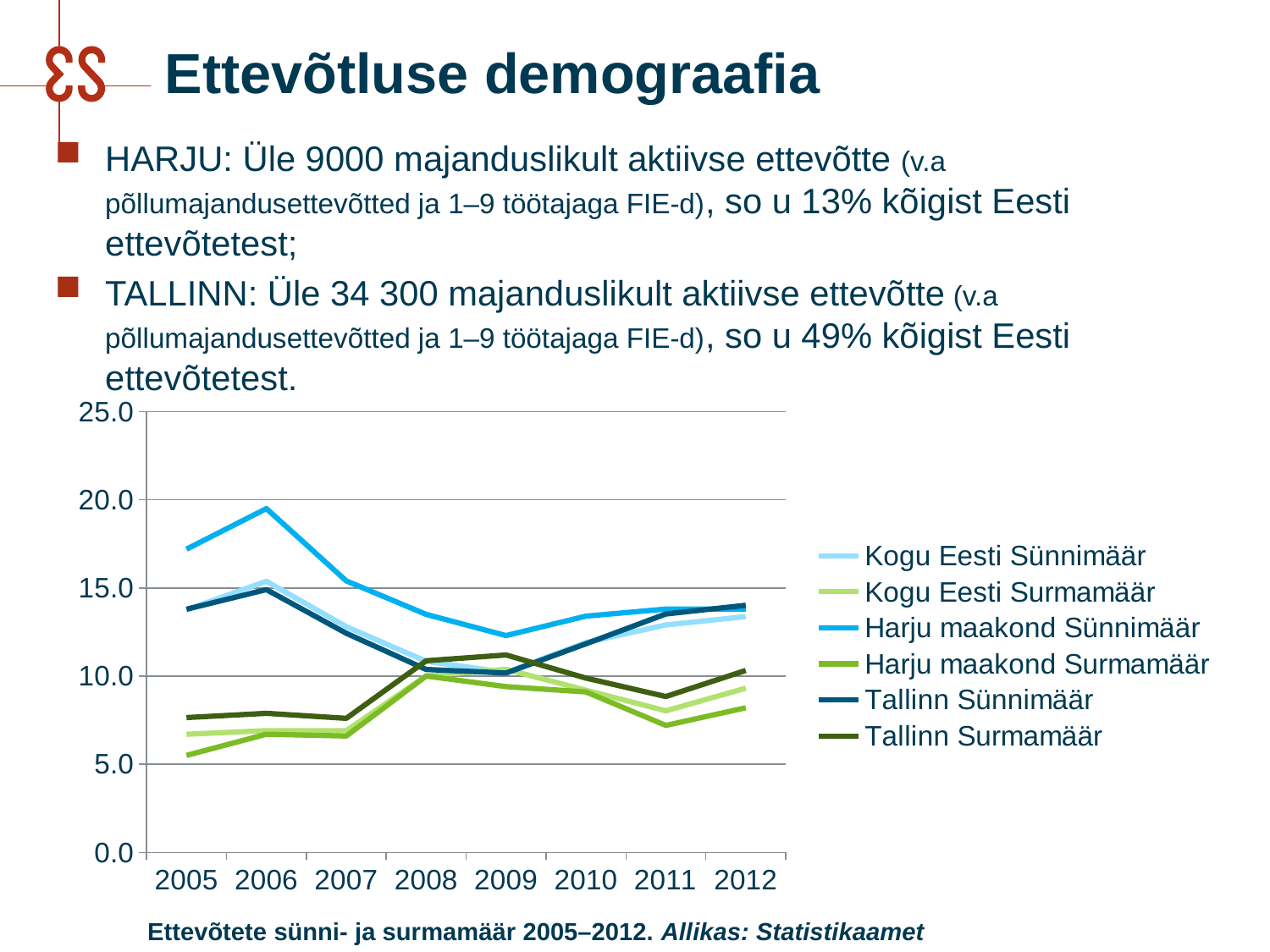
What kind of chart is shown on the slide? line chart Is the value for Tallinn Sünnimäär in 2005 greater or less than 15.0? less In 2005, which is larger: Harju maakond Sünnimäär or Tallinn Sünnimäär? Harju maakond Sünnimäär Is the value for Kogu Eesti Surmamäär in 2011 greater or less than 10.0? less Does the Harju maakond Sünnimäär line rise or fall from 2006 to 2009? fall How many series does the chart legend list? 6 Is the value for Tallinn Surmamäär in 2009 greater or less than 10.0? greater In which year is the Harju maakond Surmamäär line at its lowest value? 2005 What is the first series listed in the chart legend? Kogu Eesti Sünnimäär How many years are shown on the x axis of the chart? 8 In which year does the Harju maakond Sünnimäär line reach its highest value? 2006